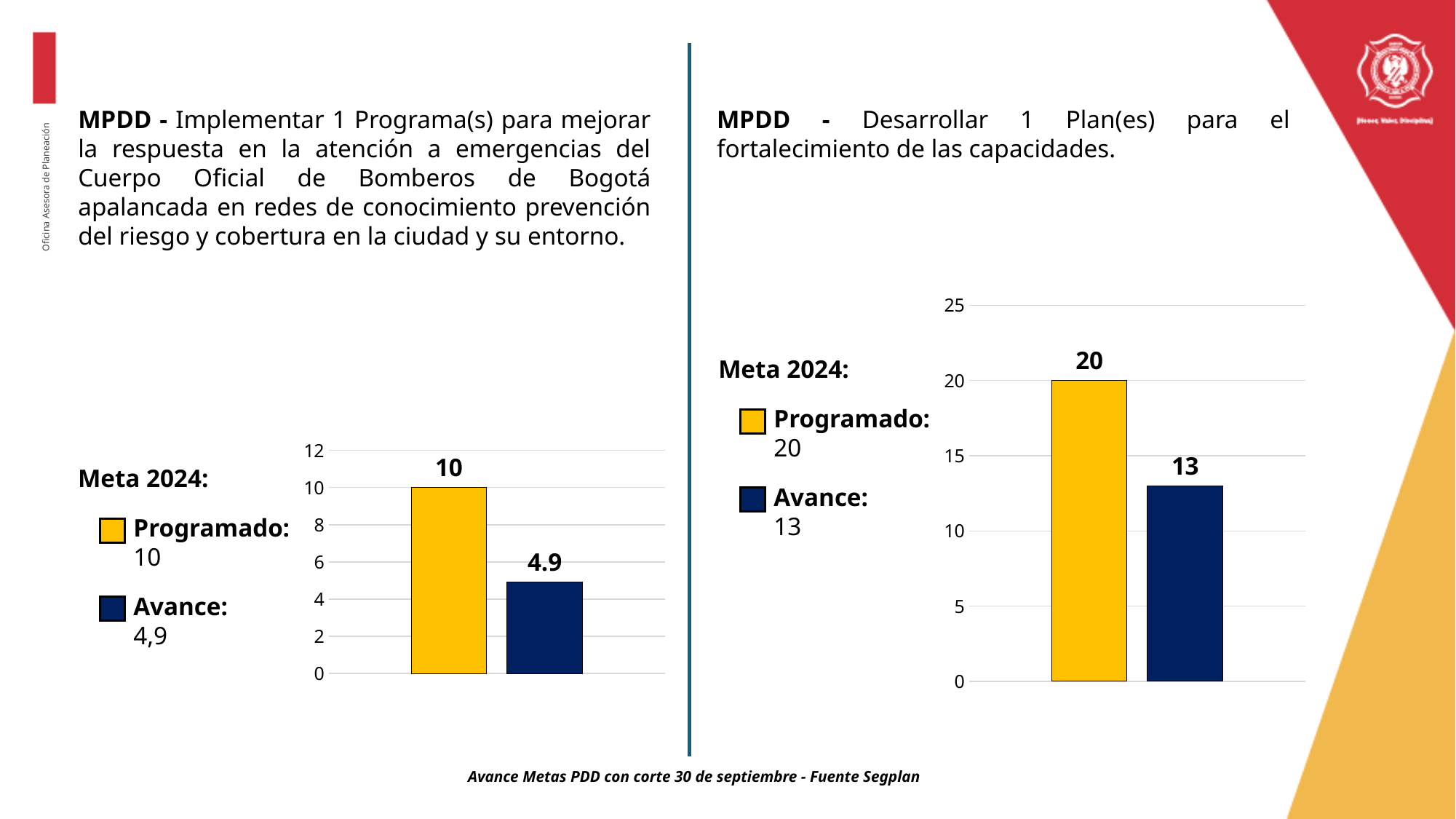
In the right chart, which bar is the lowest? Avance How many bars are plotted in the left chart? 2 In the right chart, what is the value of the Avance bar? 13 In the left chart, what is the difference between the Programado and Avance values? 5.1 What kind of chart is the right chart? bar chart In the left chart, what is the value of the Programado bar? 10 In the right chart, is the value for Avance greater or less than 15? less In the left chart, what is the value of the Avance bar? 4.9 In the right chart, what is the difference between the Programado and Avance values? 7 In the left chart, which bar is higher, Programado or Avance? Programado In the right chart, what is the value of the Programado bar? 20 In the left chart, what colour is the Programado bar? yellow